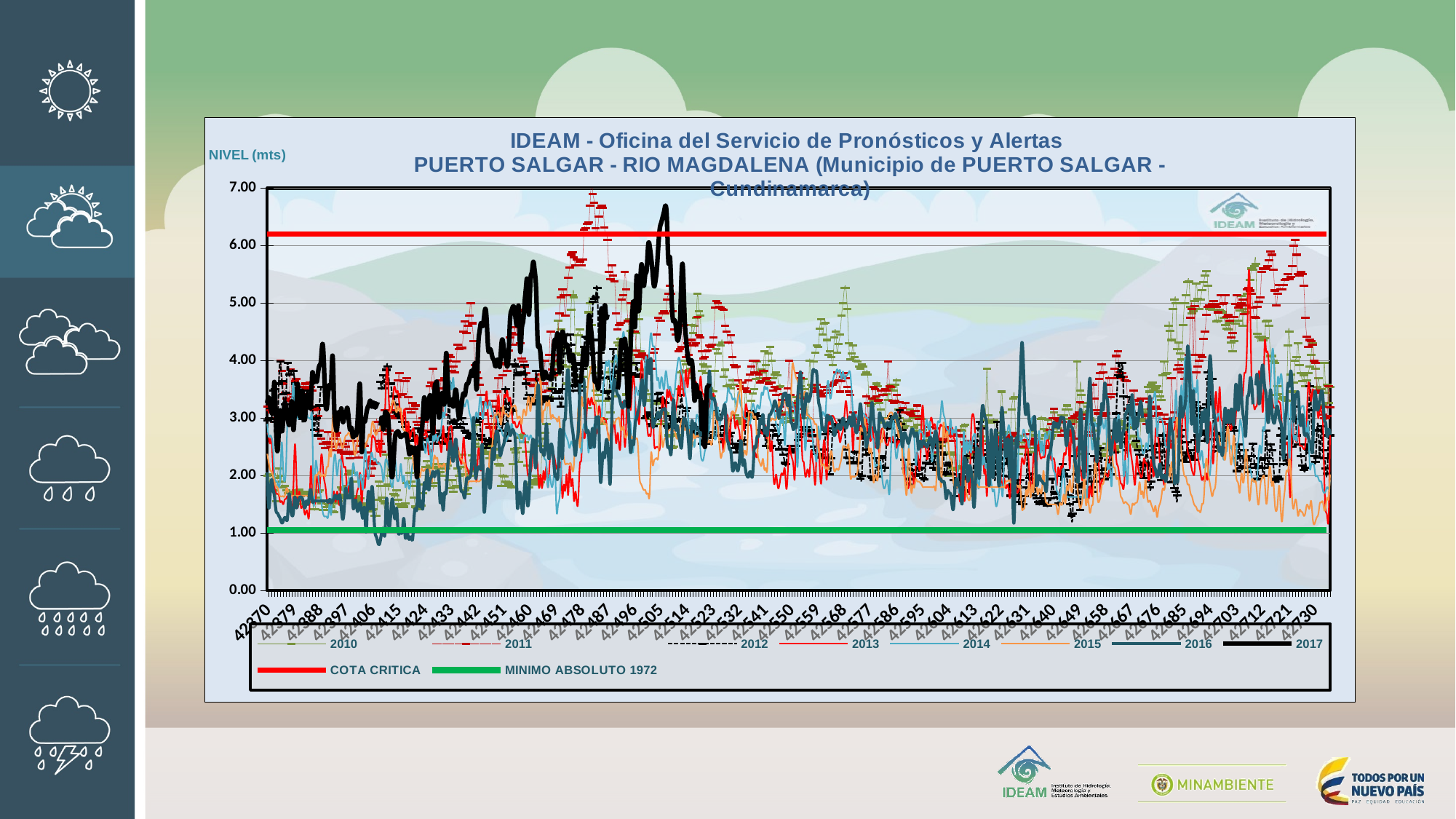
Is the MINIMO ABSOLUTO 1972 line greater or less than 2.00? less Is the COTA CRITICA line greater or less than 7.00? less What kind of chart is shown on the slide? line chart Which station and river are named in the chart title? PUERTO SALGAR - RIO MAGDALENA Is the COTA CRITICA line greater or less than 6.00? greater Which is higher on the chart, the COTA CRITICA line or the MINIMO ABSOLUTO 1972 line? COTA CRITICA Does the 2017 series ever rise above the COTA CRITICA line? yes What is the label on the vertical axis of the chart? NIVEL (mts) How many series does the legend list? 10